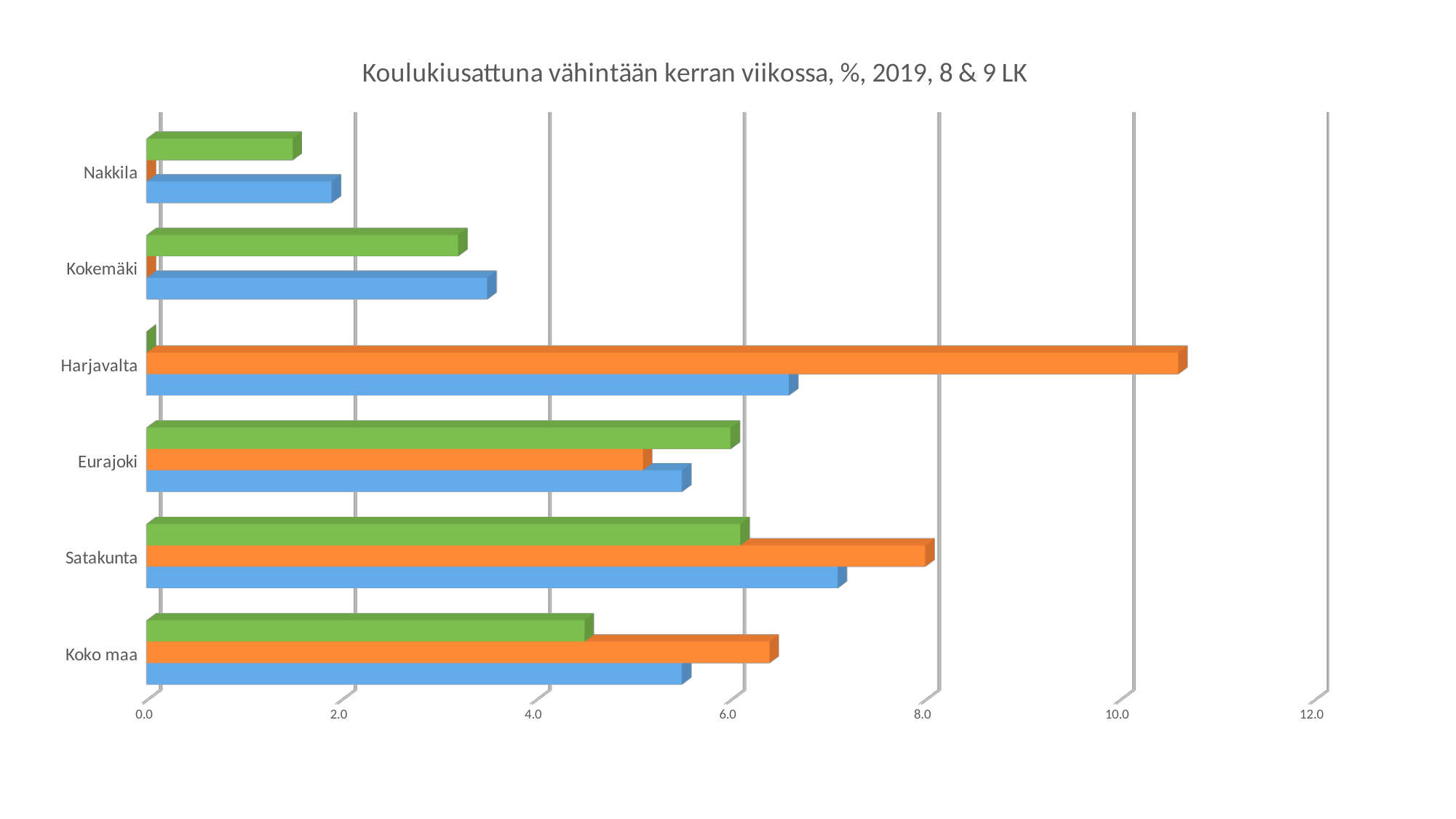
What kind of chart is shown on the slide? bar chart Is the blue bar for Satakunta greater or less than 8.0? less Is the green bar for Kokemäki greater or less than 4.0? less For Satakunta, which is larger: the orange bar or the green bar? the orange bar Among the blue bars, which category has the lowest value? Nakkila For Koko maa, which is larger: the orange bar or the blue bar? the orange bar Which category contains the longest bar in the chart? Harjavalta How many categories are listed on the vertical axis of the chart? 6 Is the orange bar for Harjavalta greater or less than 10.0? greater What is the title of the chart? Koulukiusattuna vähintään kerran viikossa, %, 2019, 8 & 9 LK